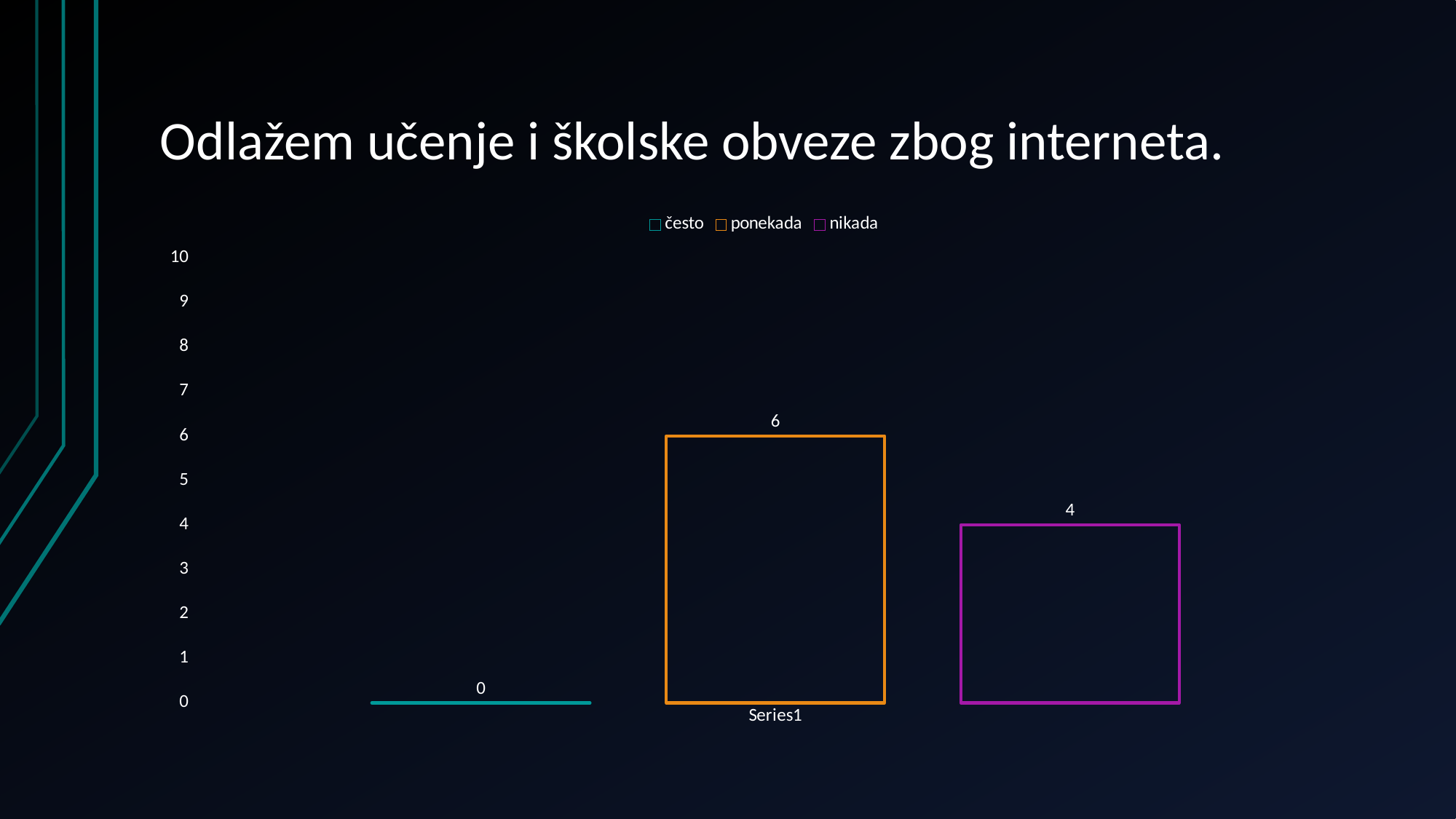
Is the value for "ponekada" greater or less than 5? greater What is the value for "nikada"? 4 What kind of chart is shown on the slide? bar chart What is the title of the slide? Odlažem učenje i školske obveze zbog interneta. What is the value for "ponekada"? 6 Which series has the highest value? ponekada What is the category label shown on the x axis? Series1 How many series does the legend list? 3 What is the value for "često"? 0 Which series has the lowest value? često Which is larger, the value for "nikada" or the value for "često"? nikada What is the difference between the values for "ponekada" and "nikada"? 2